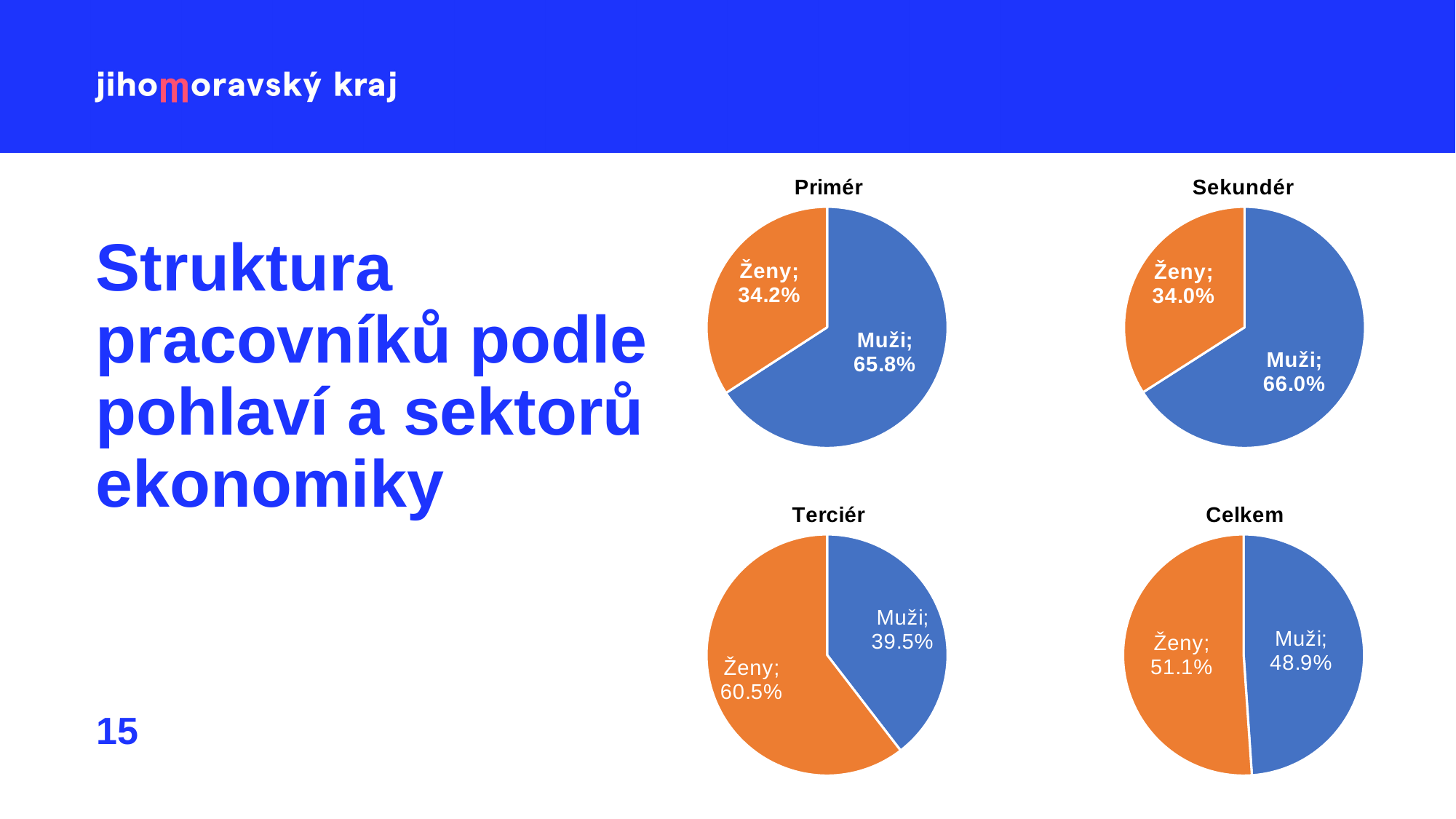
How many slices does the Celkem chart have? 2 In the Celkem chart, what share is labelled for Muži? 48.9% In the Celkem chart, which slice is larger, Ženy or Muži? Ženy In the Primér chart, what share is labelled for Muži? 65.8% What kind of chart is the Sekundér chart? Pie chart In the Primér chart, what is the difference between the Muži and Ženy shares? 31.6% In the Primér chart, what share is labelled for Ženy? 34.2% In the Terciér chart, which slice is the largest? Ženy In the Terciér chart, what share is labelled for Muži? 39.5% In the Sekundér chart, what share is labelled for Ženy? 34.0% In the Terciér chart, what share is labelled for Ženy? 60.5% In the Sekundér chart, what share is labelled for Muži? 66.0%